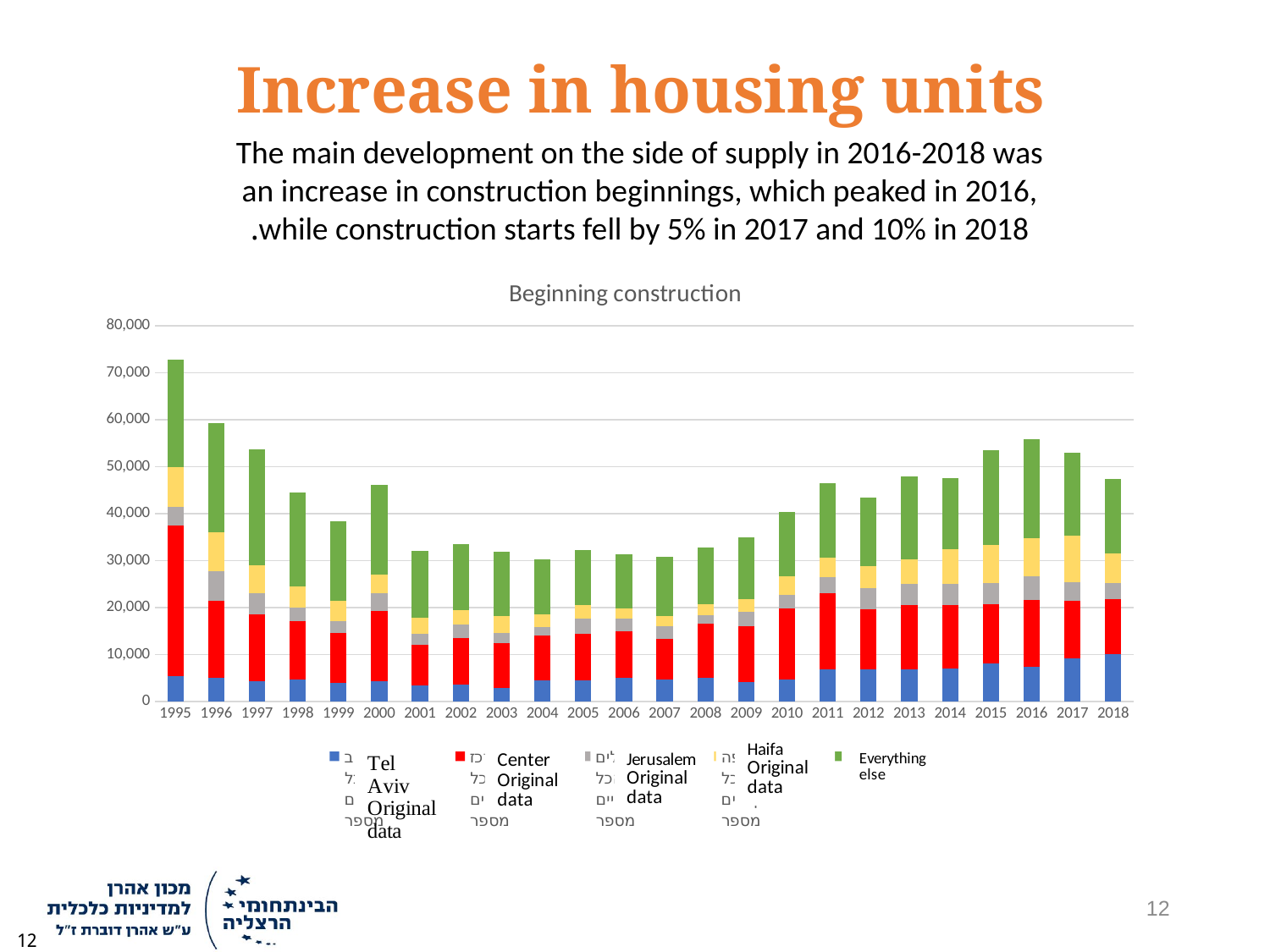
How many series does the chart's legend list? 5 Is the total value for 2001 greater or less than 40,000? less How many years are shown along the x axis of the chart? 24 Is the total value for 1995 greater or less than 70,000? greater Is the total value for 2016 greater or less than 50,000? greater Which legend series is shown in green? Everything else Which year has the larger total, 2012 or 2016? 2016 Do the total values rise or fall from 2009 to 2016? rise What is the title of the chart? Beginning construction Which year has the highest total of beginning construction? 1995 What kind of chart is shown on the slide? Stacked bar chart